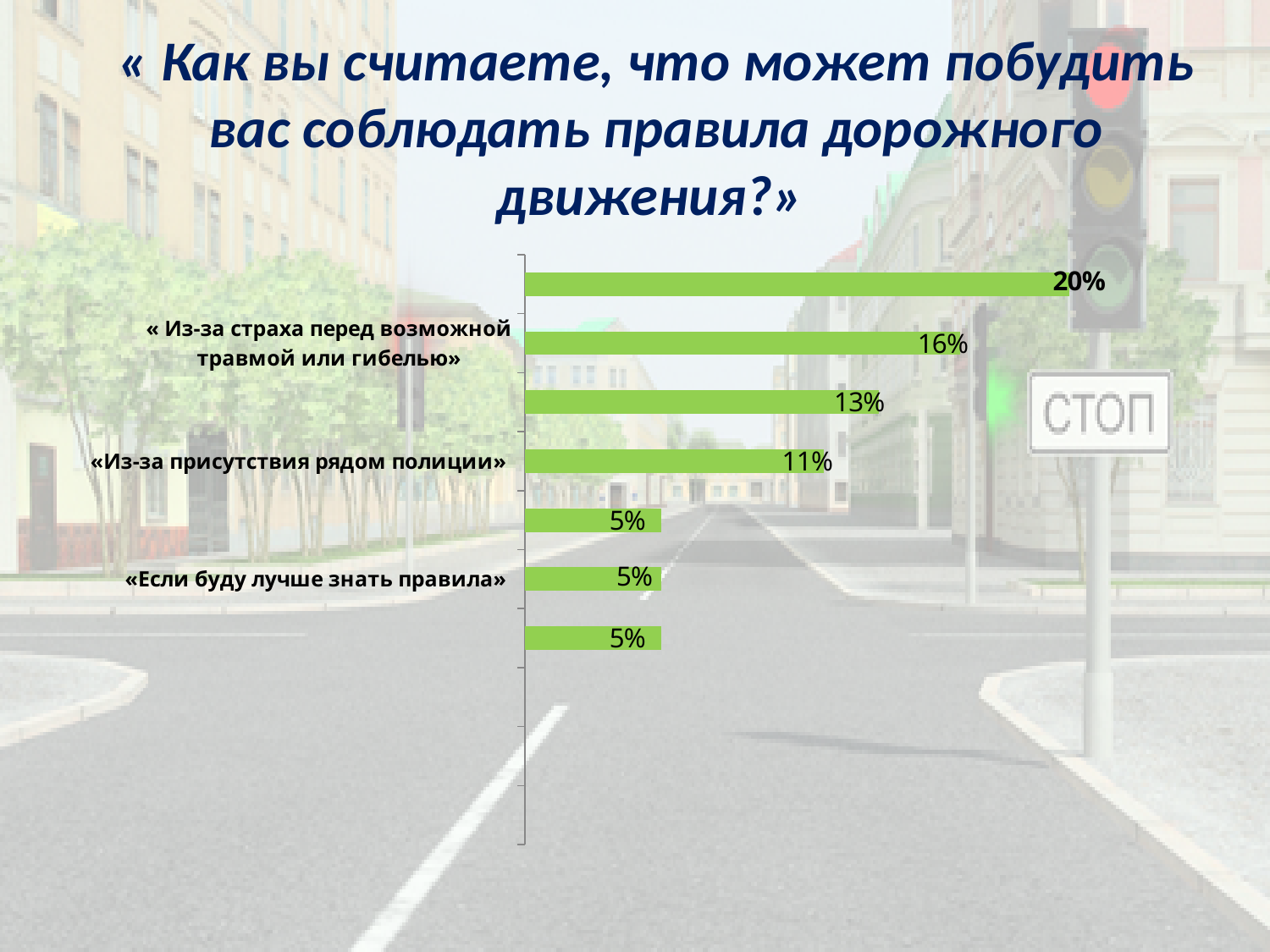
What is the value for «Из-за присутствия рядом полиции»? 11% What kind of chart is shown on the slide? bar chart What is the difference between the values for «Из-за страха перед возможной травмой или гибелью» and «Из-за присутствия рядом полиции»? 5% What is the value for «Если буду лучше знать правила»? 5% What is the lowest value shown in the chart? 5% Which is larger: the value for «Из-за страха перед возможной травмой или гибелью» or the value for «Из-за присутствия рядом полиции»? «Из-за страха перед возможной травмой или гибелью» What is the difference between the values for «Из-за присутствия рядом полиции» and «Если буду лучше знать правила»? 6% How many bars are plotted in the chart? 7 What is the value for «Из-за страха перед возможной травмой или гибелью»? 16% What colour are the bars in the chart? green What is the highest value shown in the chart? 20% How many bars in the chart have a value of 5%? 3